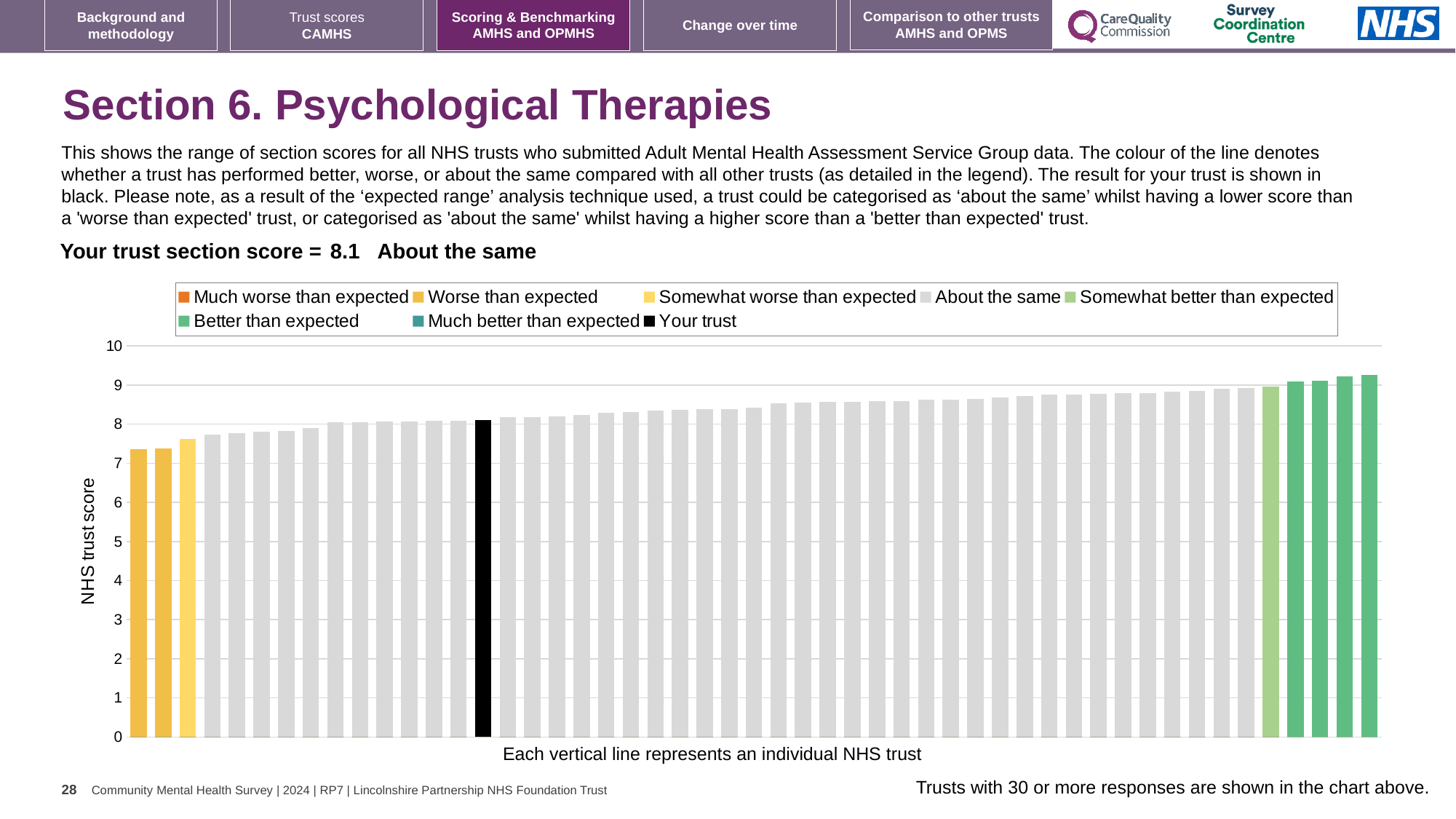
Is the value of the black 'Your trust' bar greater or less than 8? greater What is the label on the vertical axis of the chart? NHS trust score Is the value of the leftmost bar in the chart greater or less than 8? less What colour is used for the 'Your trust' bar in the chart? black How many entries does the chart legend list? 8 What kind of chart is shown on the slide? bar chart Is the value of the tallest bar in the chart greater or less than 9? greater How many bars are coloured as 'Better than expected' (dark green)? 4 Which legend category does the shortest bar in the chart belong to? Worse than expected Which legend category does the tallest bar in the chart belong to? Better than expected Do the bar values rise or fall from left to right along the x axis? rise What is the section score for your trust shown on the slide? 8.1